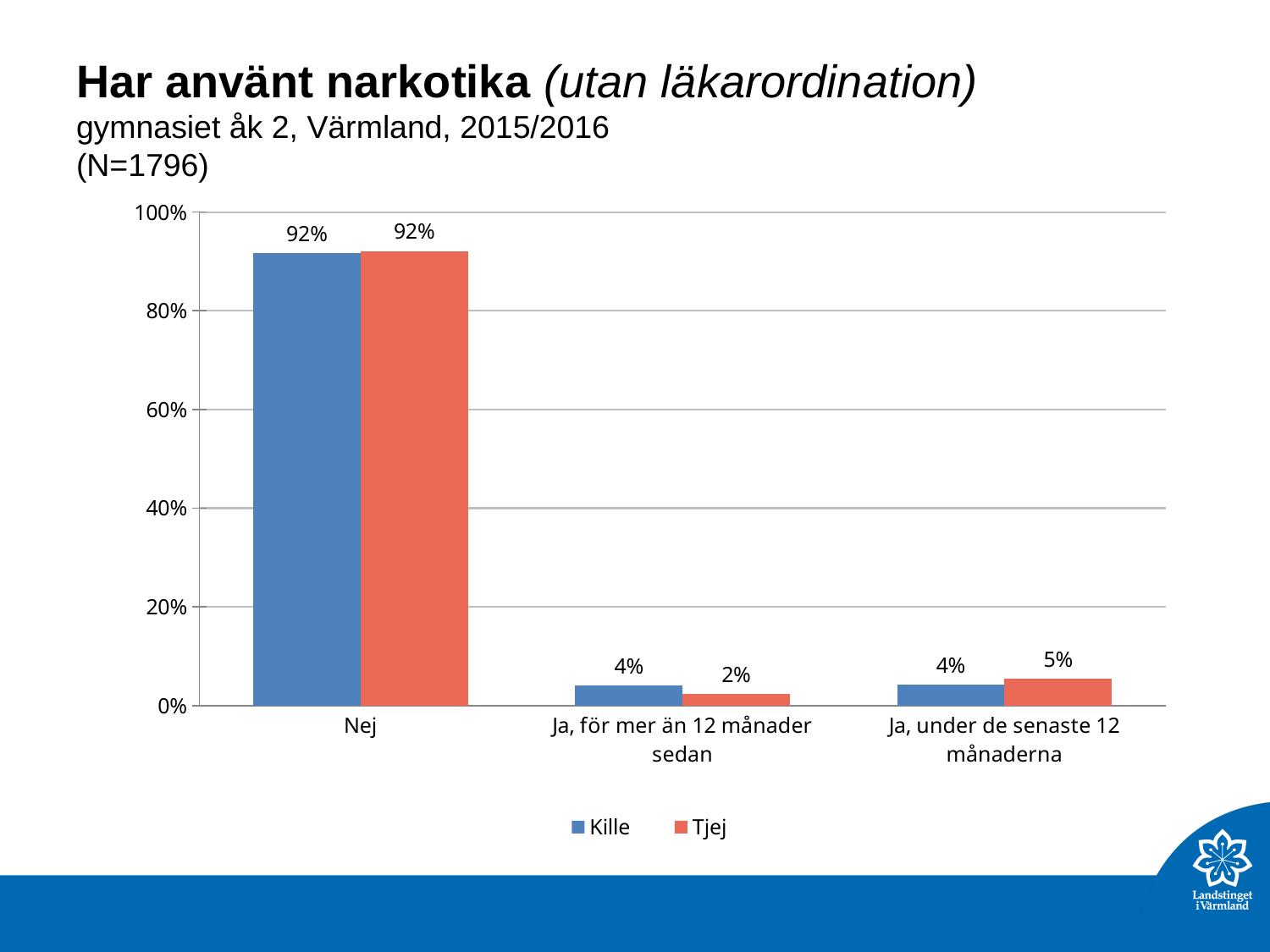
In the "Ja, under de senaste 12 månaderna" category, which series has the larger value, Kille or Tjej? Tjej What is the value for Tjej in the "Ja, under de senaste 12 månaderna" category? 5% What is the value for Kille in the "Nej" category? 92% Is the value for Kille in the "Nej" category greater or less than 80%? greater How many categories are shown on the x axis? 3 What is the value for Tjej in the "Ja, för mer än 12 månader sedan" category? 2% Which category has the lowest value for Tjej? Ja, för mer än 12 månader sedan How many series does the legend list? 2 What is the difference between the Kille and Tjej values in the "Ja, för mer än 12 månader sedan" category? 2% What kind of chart is shown on the slide? Bar chart Which category has the highest value for Tjej? Nej What is the value for Kille in the "Ja, under de senaste 12 månaderna" category? 4%